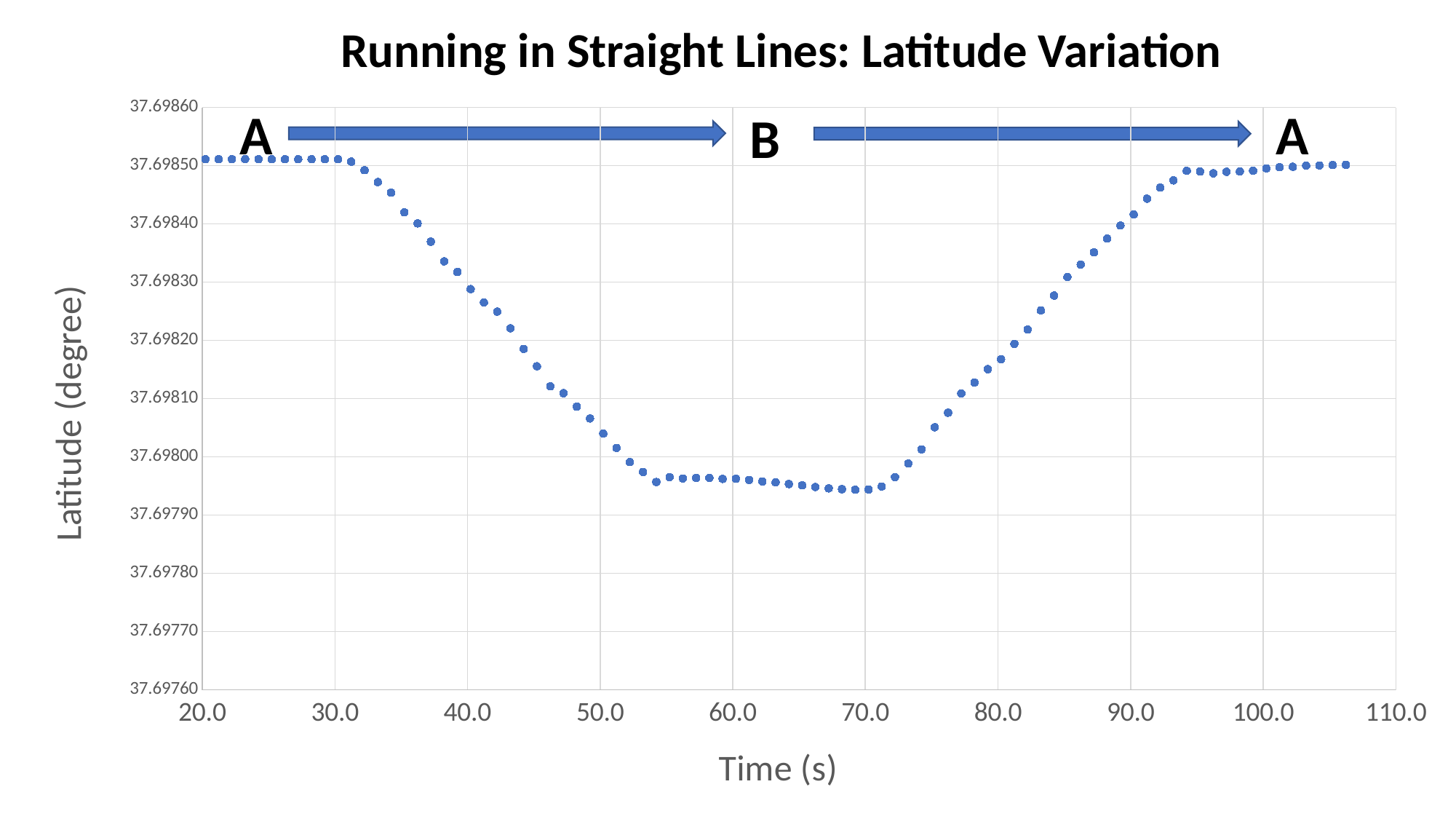
Is the latitude at time 20.0 s greater or less than 37.69840? greater Is the latitude at time 40.0 s higher or lower than at time 60.0 s? higher Is the latitude at time 40.0 s greater or less than 37.69840? less Is the latitude at time 100.0 s greater or less than 37.69830? greater What is the title of the chart? Running in Straight Lines: Latitude Variation What is the label of the horizontal axis? Time (s) Is the latitude at time 50.0 s higher or lower than at time 90.0 s? lower What kind of chart is shown on the slide? Scatter chart Between time 30.0 s and 55.0 s, do the latitude values rise or fall? fall Between time 70.0 s and 95.0 s, do the latitude values rise or fall? rise